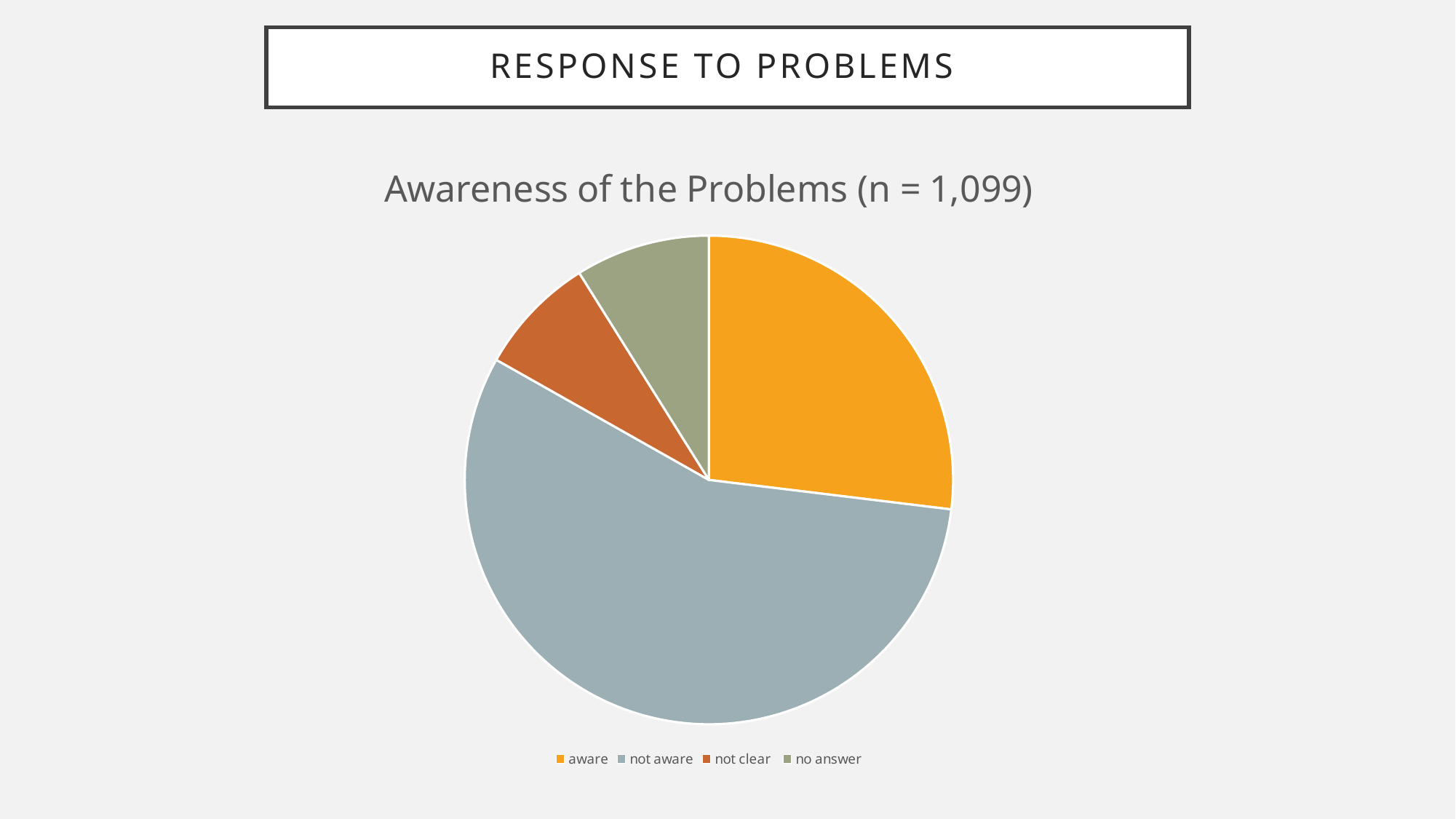
What is the title of the chart? Awareness of the Problems (n = 1,099) What kind of chart is shown on the slide? pie chart What colour is the slice for 'aware'? orange Which slice is larger, aware or no answer? aware Which slice is larger, aware or not aware? not aware How many slices does the pie chart have? 4 How many categories does the legend list? 4 What is the sample size shown in the chart title? 1,099 Which category has the largest slice of the pie? not aware Which slice is larger, no answer or not aware? not aware